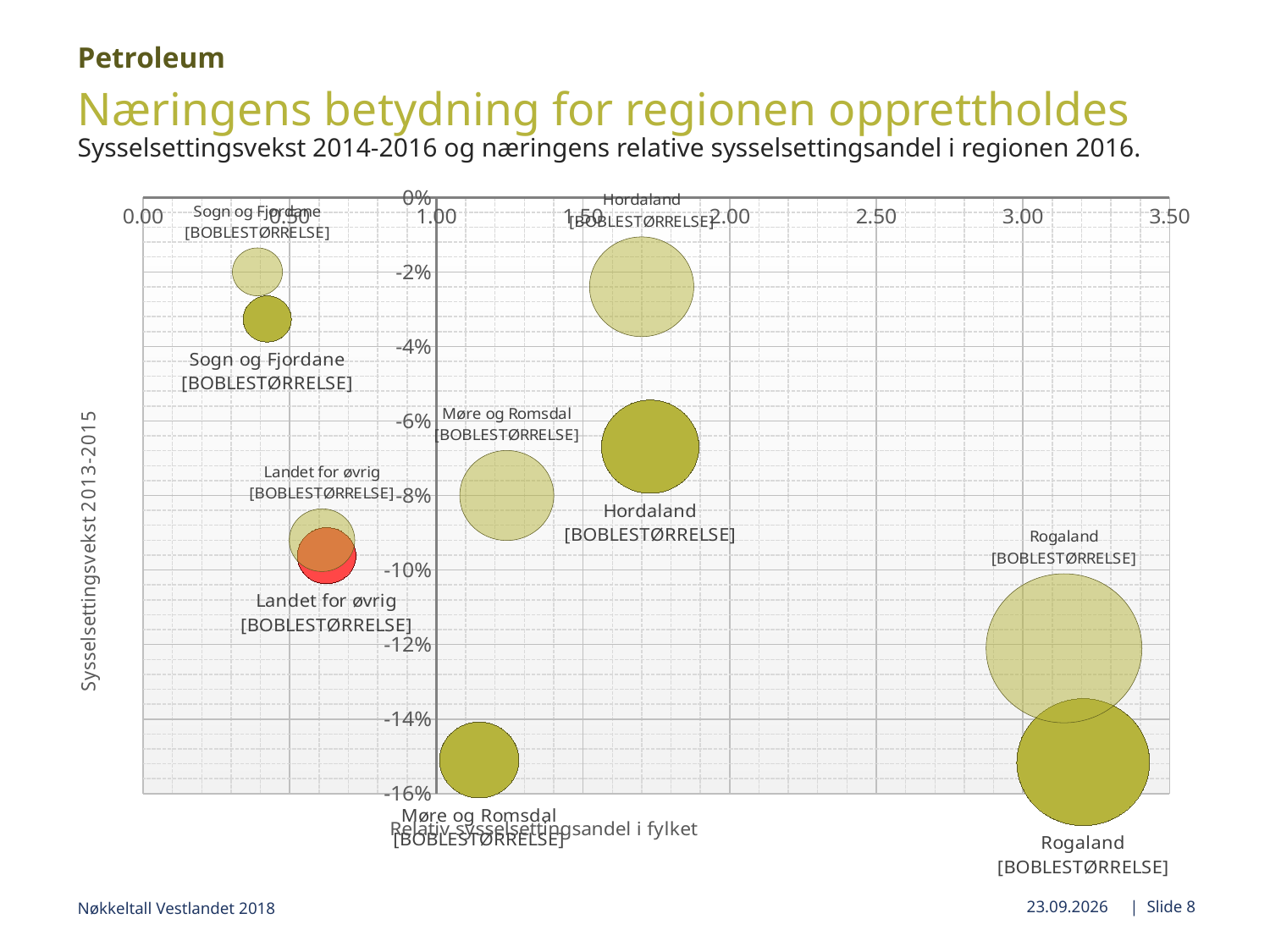
What is the title of the x axis? Relativ sysselsettingsandel i fylket How many regions are labelled in the chart? 5 Which region has the lowest relative employment share (furthest left on the x axis)? Sogn og Fjordane Is the relative employment share for Hordaland greater or less than 1.50? greater Which region has the larger bubbles, Rogaland or Sogn og Fjordane? Rogaland Is the employment growth for Rogaland greater or less than -10%? less Which region has the highest relative employment share (furthest right on the x axis)? Rogaland What kind of chart is shown on the slide? bubble chart Which region is plotted with a red bubble? Landet for øvrig Is the relative employment share for Rogaland greater or less than 3.00? greater